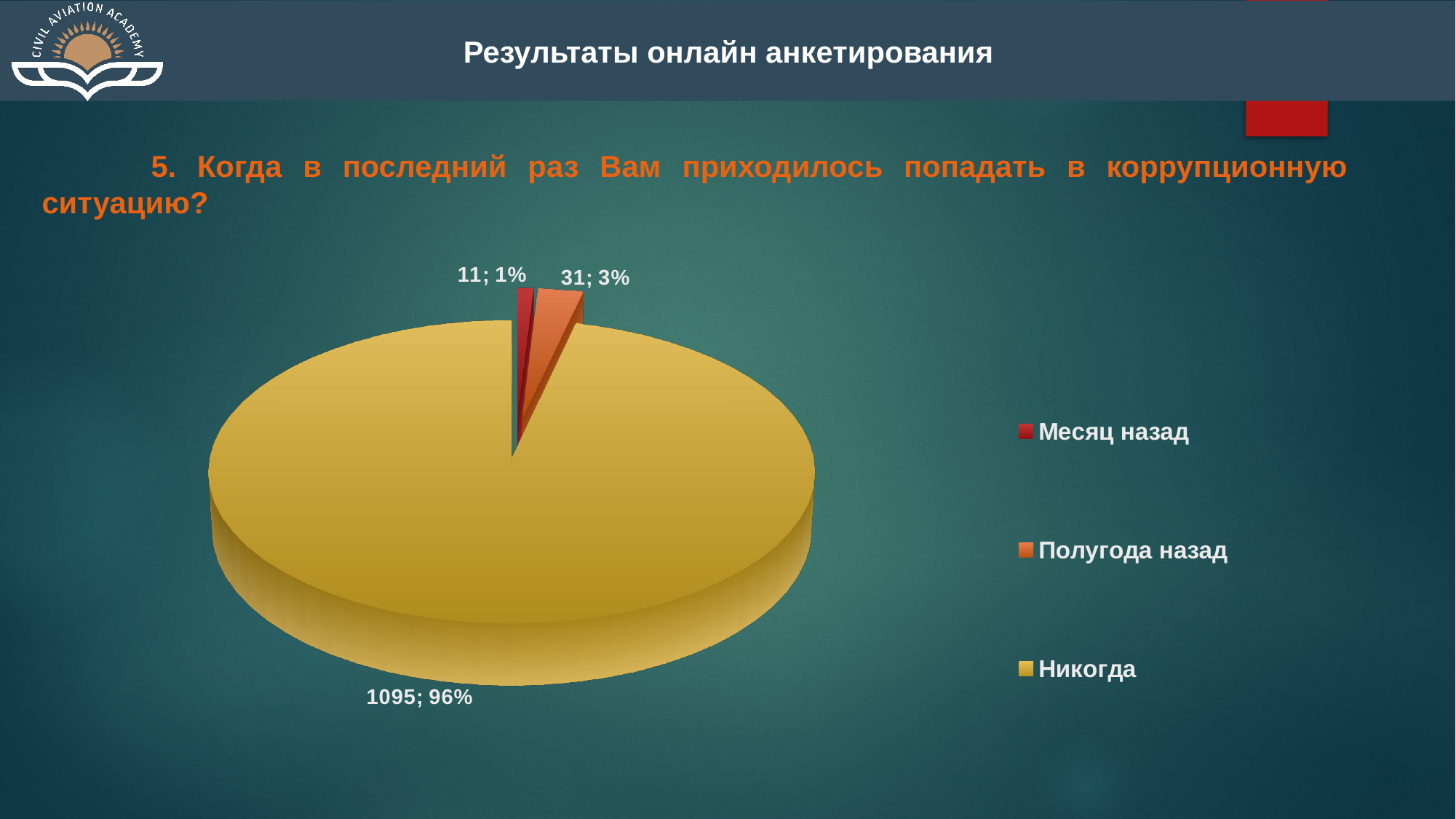
How many slices does the pie chart have? 3 What is the difference between the counts for "Полугода назад" and "Месяц назад"? 20 How many entries does the legend list? 3 What is the count for "Полугода назад"? 31 What is the count for "Никогда"? 1095 What share of the pie does "Полугода назад" represent? 3% What kind of chart is shown on the slide? Pie chart Which category has the smallest slice? Месяц назад What is the count for "Месяц назад"? 11 Which category has the largest slice? Никогда What share of the pie does "Никогда" represent? 96% Which colour represents "Никогда" in the legend? Yellow